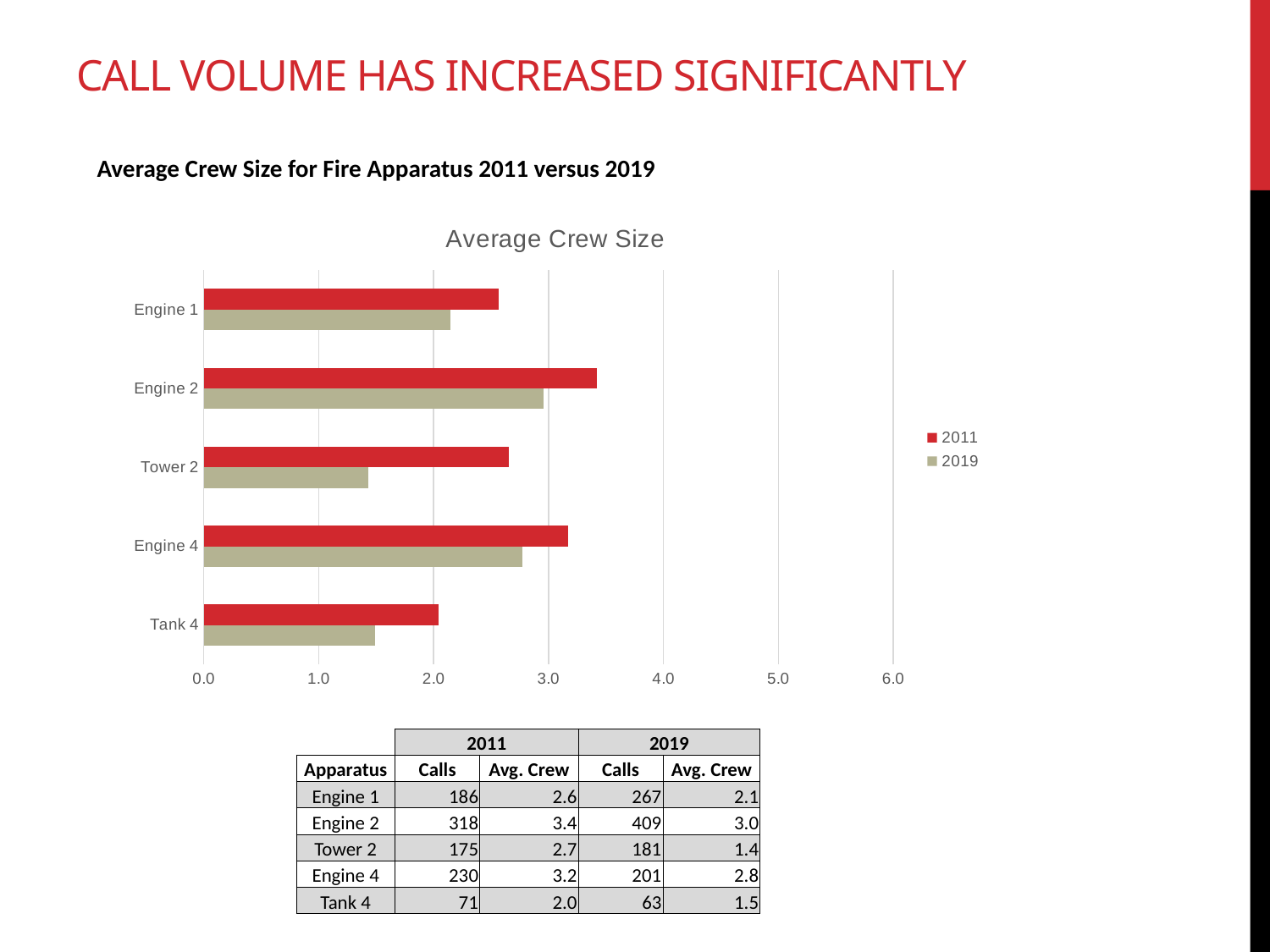
Which apparatus has the lowest average crew size in 2019? Tower 2 Is the 2019 average crew size for Tank 4 greater or less than 2.0? less How many series does the chart legend list? 2 How many apparatus categories are plotted in the Average Crew Size chart? 5 Is the 2019 average crew size for Engine 2 greater or less than 2.0? greater What kind of chart is shown on the slide? bar chart What is the difference between the 2011 and 2019 average crew size for Tower 2? 1.3 What is the average crew size for Tower 2 in 2019? 1.4 Which is larger, the 2011 average crew size for Engine 4 or for Engine 1? Engine 4 What is the title of the chart? Average Crew Size What is the average crew size for Engine 2 in 2011? 3.4 Which apparatus has the highest average crew size in 2011? Engine 2